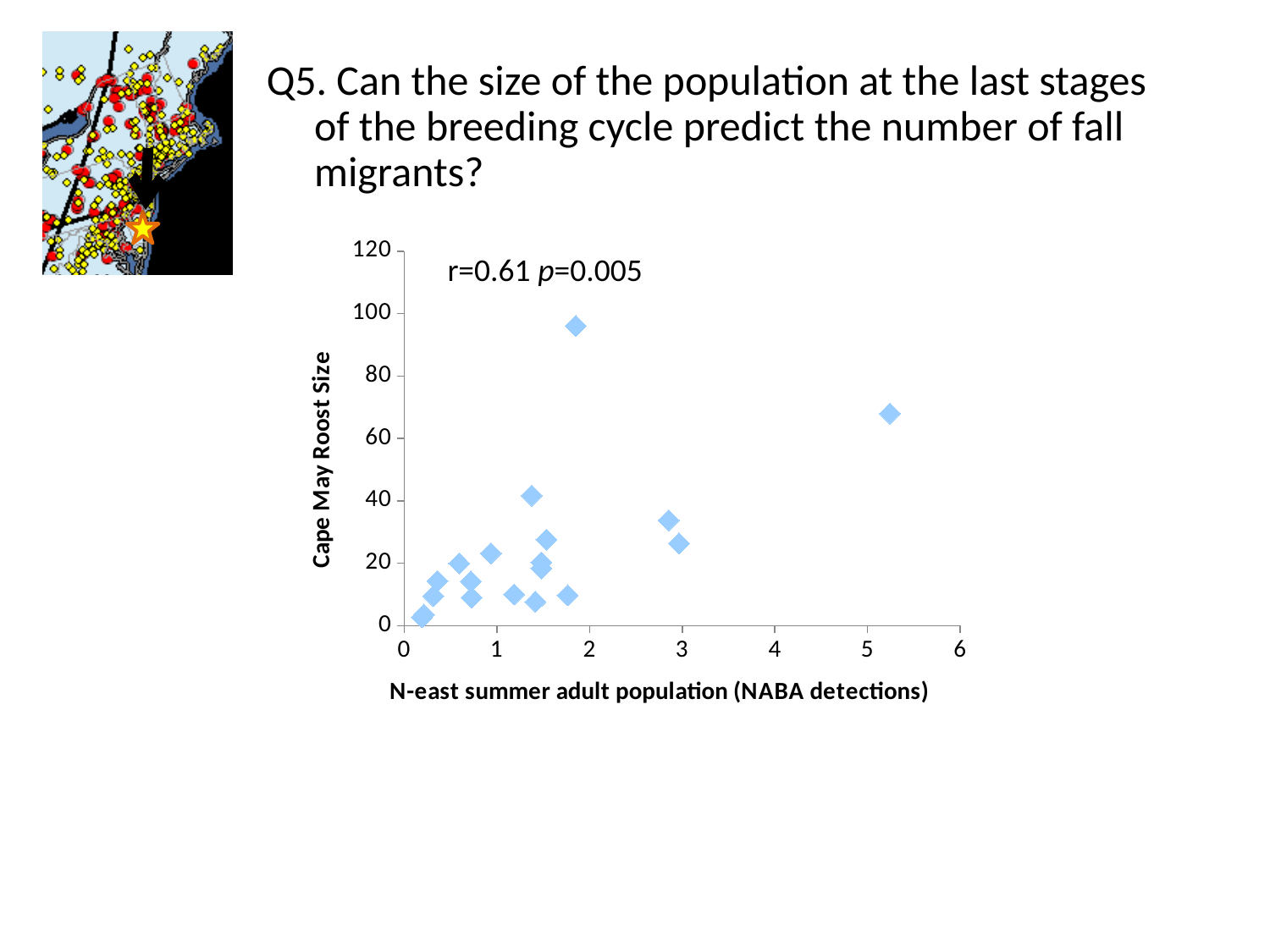
What p value is printed on the chart? p=0.005 What correlation coefficient r is printed on the chart? r=0.61 What is the label of the x axis of the chart? N-east summer adult population (NABA detections) Is the N-east summer adult population of the rightmost point greater or less than 5? greater Do Cape May Roost Size values generally rise or fall as the N-east summer adult population increases? rise Is the Cape May Roost Size of the point with the largest N-east summer adult population greater or less than 80? less What is the maximum value shown on the y axis of the chart? 120 Is the Cape May Roost Size of the point with the largest N-east summer adult population greater or less than 60? greater What is the label of the y axis of the chart? Cape May Roost Size What kind of chart is shown on the slide? scatter plot